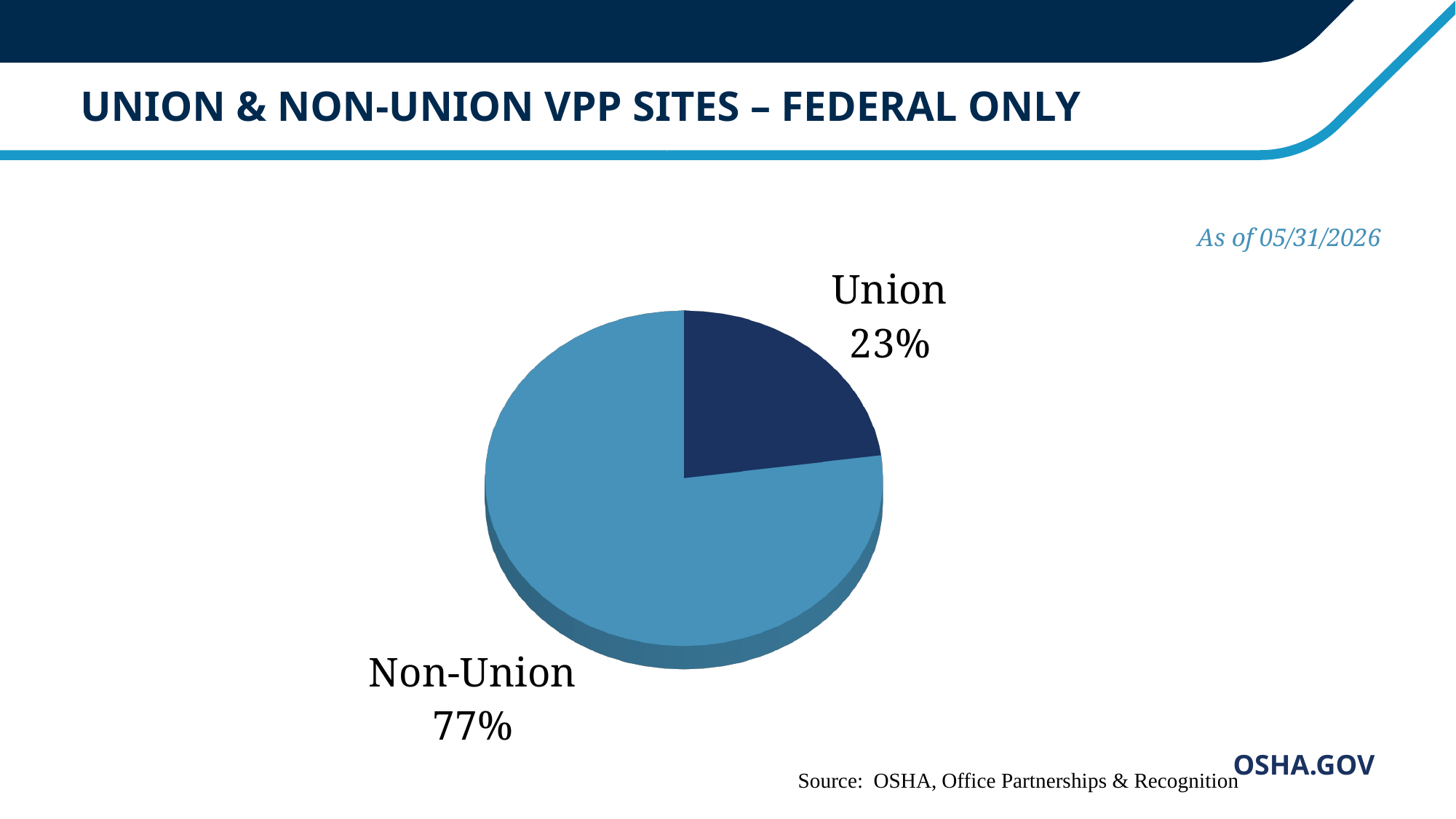
Is the Union share greater or less than 25%? less What share of the pie does the Union slice represent? 23% Which is larger, the Union slice or the Non-Union slice? Non-Union What share of the pie does the Non-Union slice represent? 77% Which category has the largest slice of the pie? Non-Union Which category has the smallest slice of the pie? Union How many slices does the pie chart have? 2 What is the title of the slide containing the chart? UNION & NON-UNION VPP SITES – FEDERAL ONLY What is the difference in percentage points between the Non-Union and Union slices? 54 What date is the chart data stated to be as of? 05/31/2026 Is the Non-Union share greater or less than 75%? greater What kind of chart is shown on the slide? Pie chart